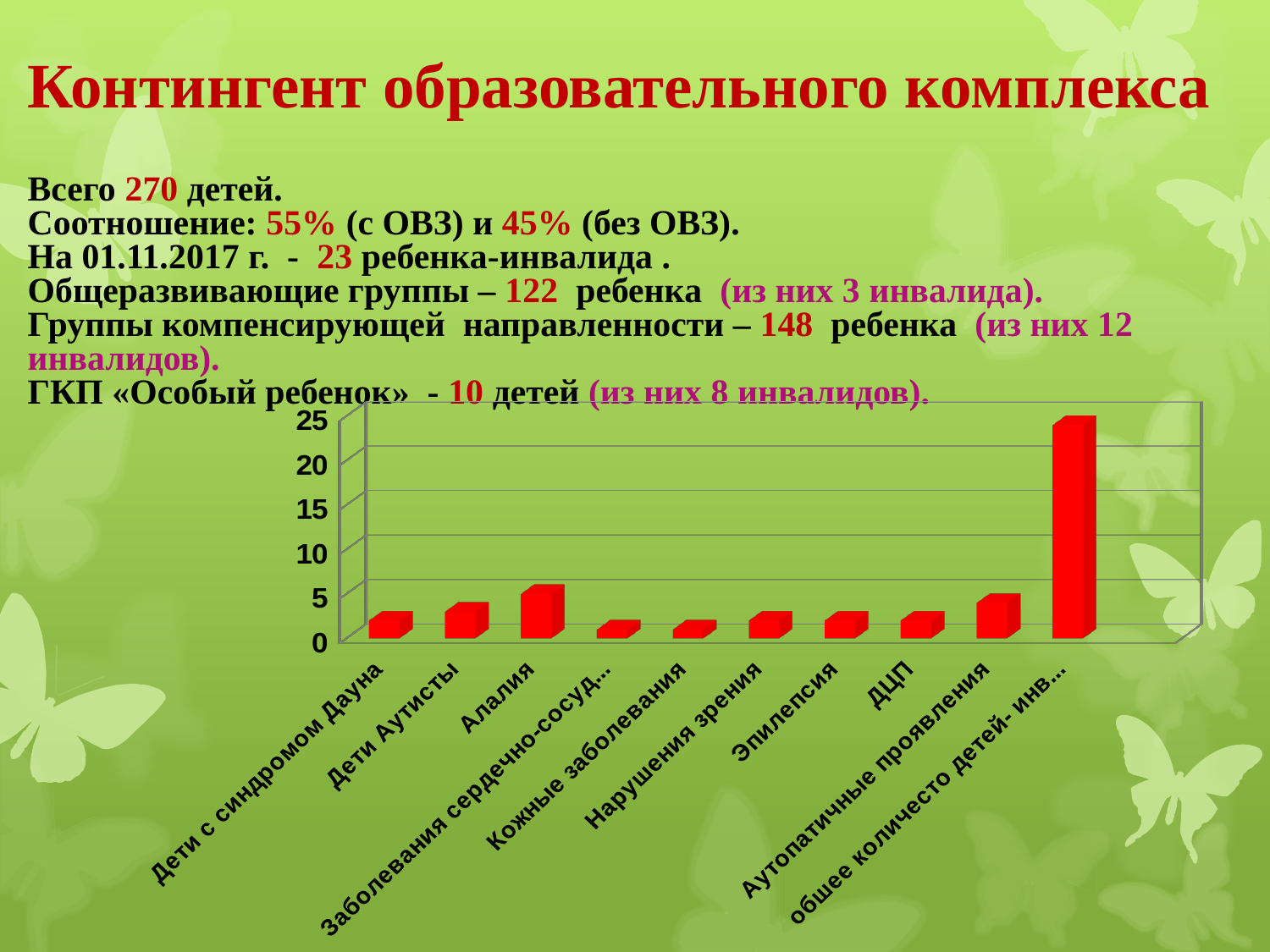
Is the value for "общее количесто детей- инв..." greater or less than 20? greater Which category has the highest bar in the chart? общее количесто детей- инв... Which is larger, the value for Алалия or the value for Кожные заболевания? Алалия Which is larger, the value for Алалия or the value for Дети с синдромом Дауна? Алалия Is the value for Алалия greater or less than 10? less Which is larger, the value for Аутопатичные проявления or the value for Эпилепсия? Аутопатичные проявления What colour are the bars in the chart? red What kind of chart is shown on the slide? bar chart How many categories are shown on the x axis of the chart? 10 Is the value for Дети с синдромом Дауна greater or less than 5? less What is the highest value shown on the y axis of the chart? 25